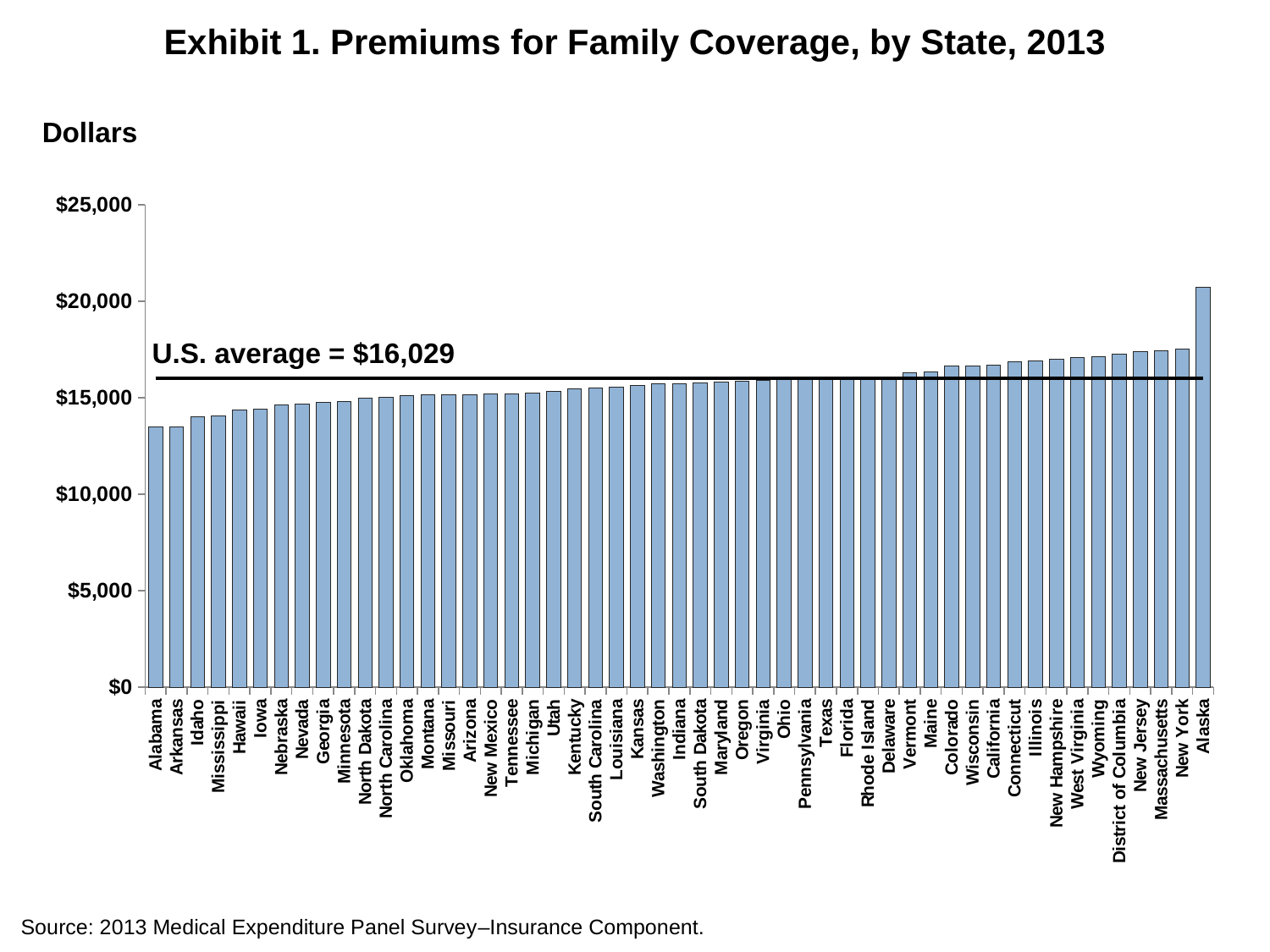
Is the value for Alaska greater or less than $20,000? greater What is the title of the chart? Exhibit 1. Premiums for Family Coverage, by State, 2013 How many states or jurisdictions are plotted in the chart? 51 Is the value for Alabama greater or less than $15,000? less Is the value for New York greater or less than $15,000? greater Which state has the highest premium for family coverage in the chart? Alaska What is the U.S. average premium for family coverage shown on the chart? $16,029 Which has a higher premium, Massachusetts or Mississippi? Massachusetts Which has a higher premium, Alaska or Alabama? Alaska Do the premium values generally rise or fall moving from left to right across the states? rise What kind of chart is shown on the slide? bar chart